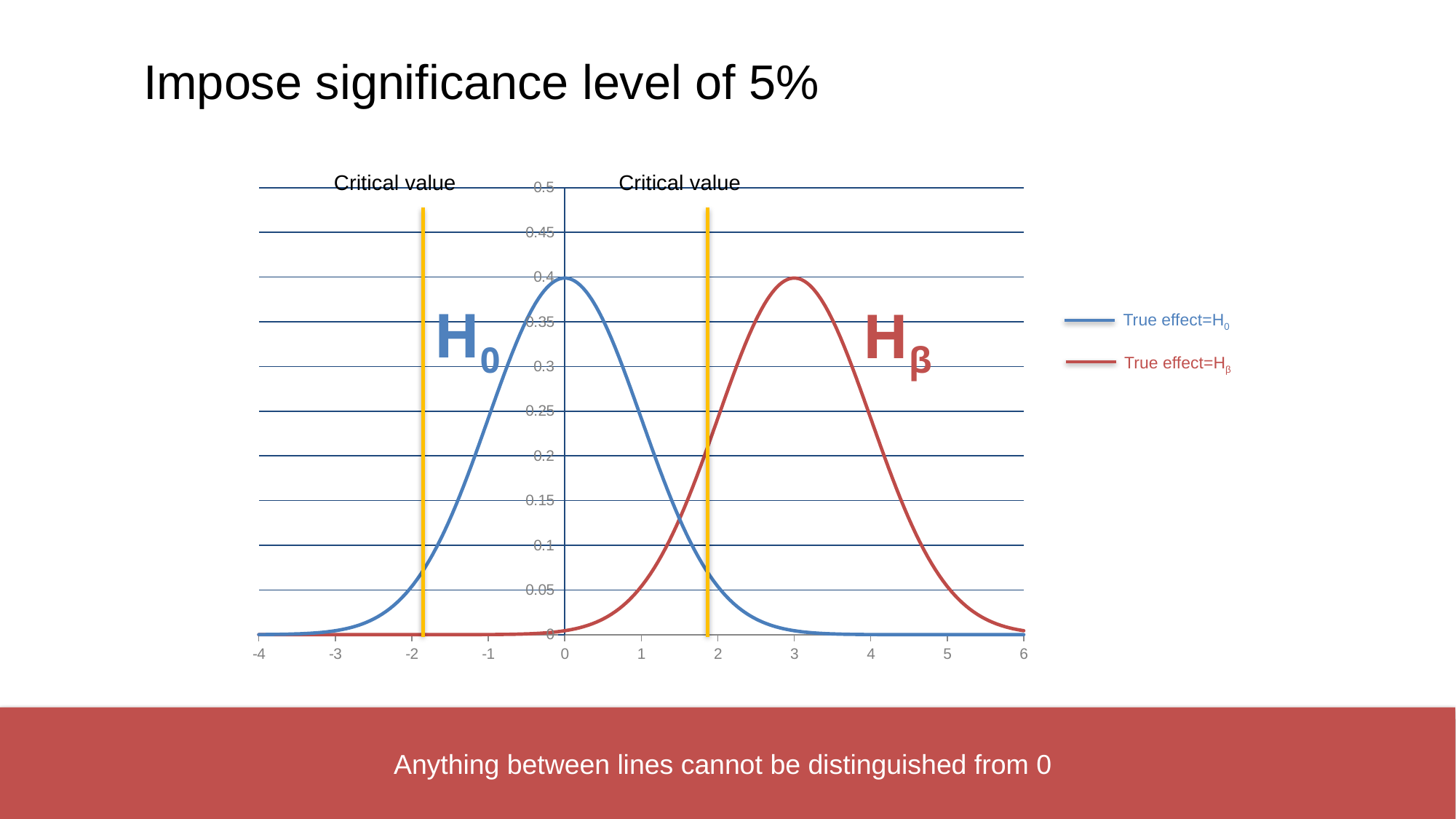
Is the peak of the blue H0 curve greater or less than 0.35? greater Does the blue H0 curve rise or fall as x goes from 0 to 6? fall At x = 3, which curve is higher, the blue H0 curve or the red Hβ curve? the red Hβ curve What colour are the vertical lines labelled 'Critical value'? yellow What are the two legend entries? True effect=H0 and True effect=Hβ At x = 1, which curve is higher, the blue H0 curve or the red Hβ curve? the blue H0 curve At which x-axis value does the red Hβ curve reach its peak? 3 Is the peak of the red Hβ curve greater or less than 0.45? less At which x-axis value does the blue H0 curve reach its peak? 0 What is the highest value shown on the y axis? 0.5 What kind of chart is shown on the slide? line chart How many series does the legend list? 2